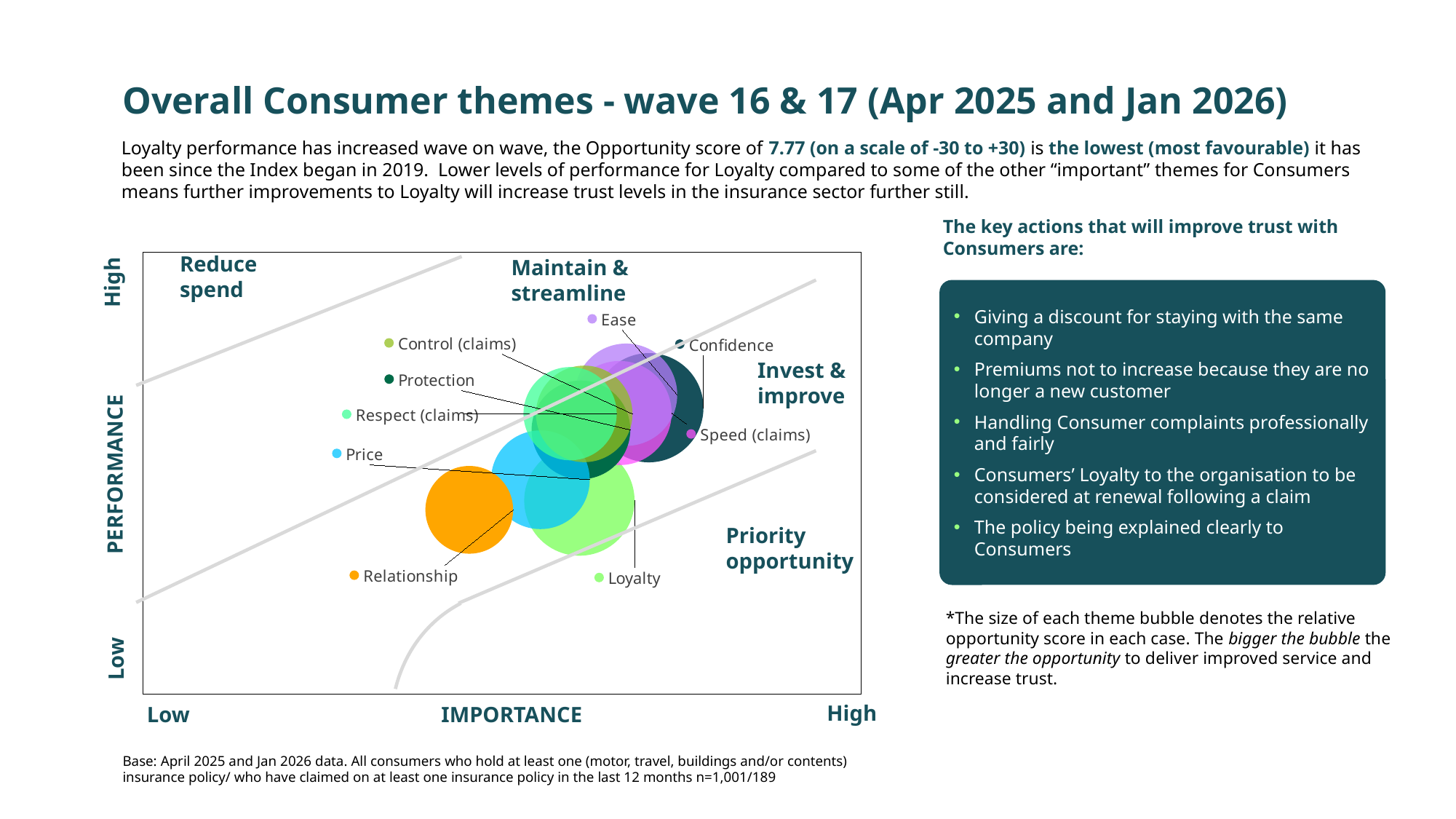
Which theme bubble is furthest to the left (lowest importance) on the chart? Relationship Which has the higher performance on the chart, Loyalty or Ease? Ease Which has the higher performance on the chart, Ease or Relationship? Ease What is the label of the vertical axis of the chart? PERFORMANCE What colour is the Relationship bubble on the chart? Orange Which has the higher importance on the chart, Price or Speed (claims)? Speed (claims) What kind of chart is shown on the slide? Bubble chart How many consumer themes are plotted as bubbles on the chart? 9 What is the label of the horizontal axis of the chart? IMPORTANCE